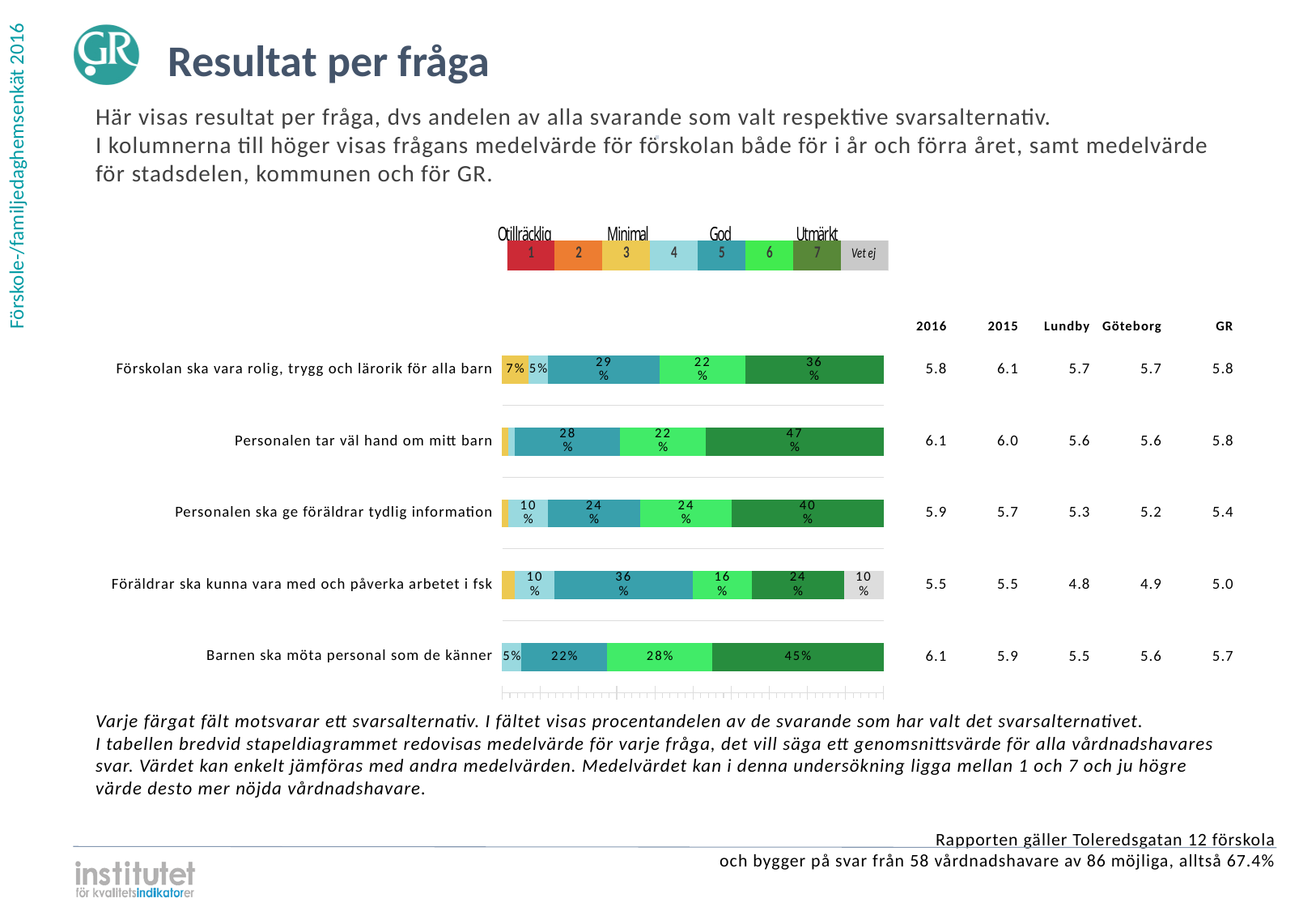
How many answer alternatives does the legend above the chart list? 8 Which question has the smallest share of respondents choosing alternative 7 (dark green)? Föräldrar ska kunna vara med och påverka arbetet i fsk What kind of chart is shown on the slide? Stacked bar chart How many questions (categories) are plotted in the bar chart? 5 Which has the larger share for alternative 5 (teal): 'Föräldrar ska kunna vara med och påverka arbetet i fsk' or 'Förskolan ska vara rolig, trygg och lärorik för alla barn'? Föräldrar ska kunna vara med och påverka arbetet i fsk What percentage chose alternative 6 (light green) for 'Barnen ska möta personal som de känner'? 28% What percentage of respondents chose alternative 7 (dark green) for 'Personalen tar väl hand om mitt barn'? 47% What label does the legend give to answer alternative 7? Utmärkt Which question has the largest share of respondents choosing alternative 7 (dark green)? Personalen tar väl hand om mitt barn How many percentage points larger is the alternative 7 share for 'Personalen tar väl hand om mitt barn' than for 'Förskolan ska vara rolig, trygg och lärorik för alla barn'? 11 percentage points What percentage answered 'Vet ej' for 'Föräldrar ska kunna vara med och påverka arbetet i fsk'? 10% In the table next to the chart, what is the 2016 mean value for 'Förskolan ska vara rolig, trygg och lärorik för alla barn'? 5.8